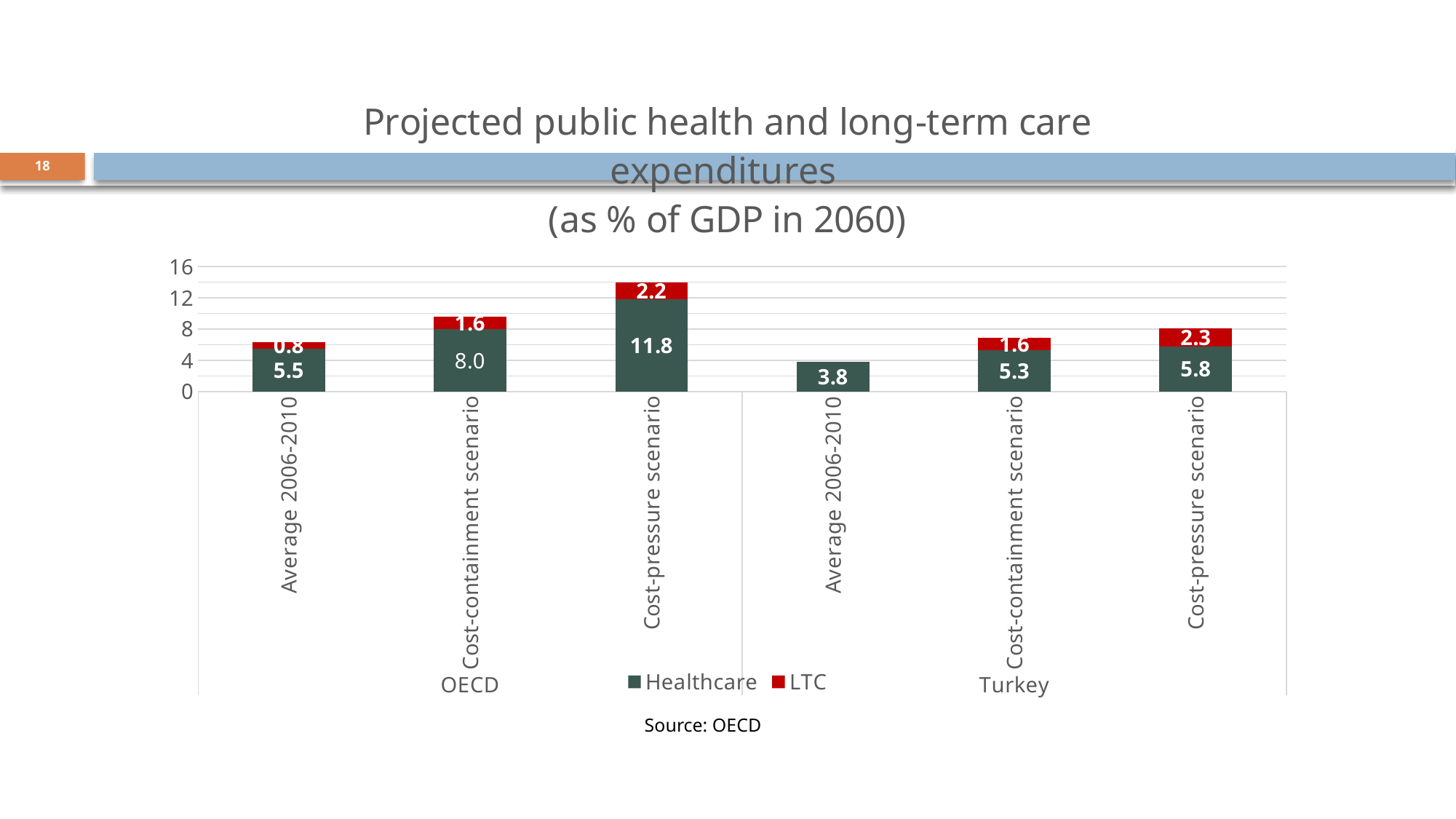
Which category has the lowest Healthcare value? Turkey Average 2006-2010 Which category has the highest Healthcare value? OECD Cost-pressure scenario What is the LTC value for the Turkey Cost-pressure scenario? 2.3 Which is larger: the LTC value for the OECD Cost-containment scenario or the LTC value for the Turkey Cost-pressure scenario? Turkey Cost-pressure scenario How many series does the legend list? 2 What is the Healthcare value for Turkey Average 2006-2010? 3.8 What is the Healthcare value for the OECD Cost-containment scenario? 8.0 How many bars are plotted in the chart? 6 What type of chart is shown on the slide? stacked bar chart What is the total of the stacked bar for the OECD Cost-pressure scenario? 14.0 What is the Healthcare value for the OECD Cost-pressure scenario? 11.8 What is the difference between the Healthcare values for the OECD and Turkey Cost-containment scenarios? 2.7